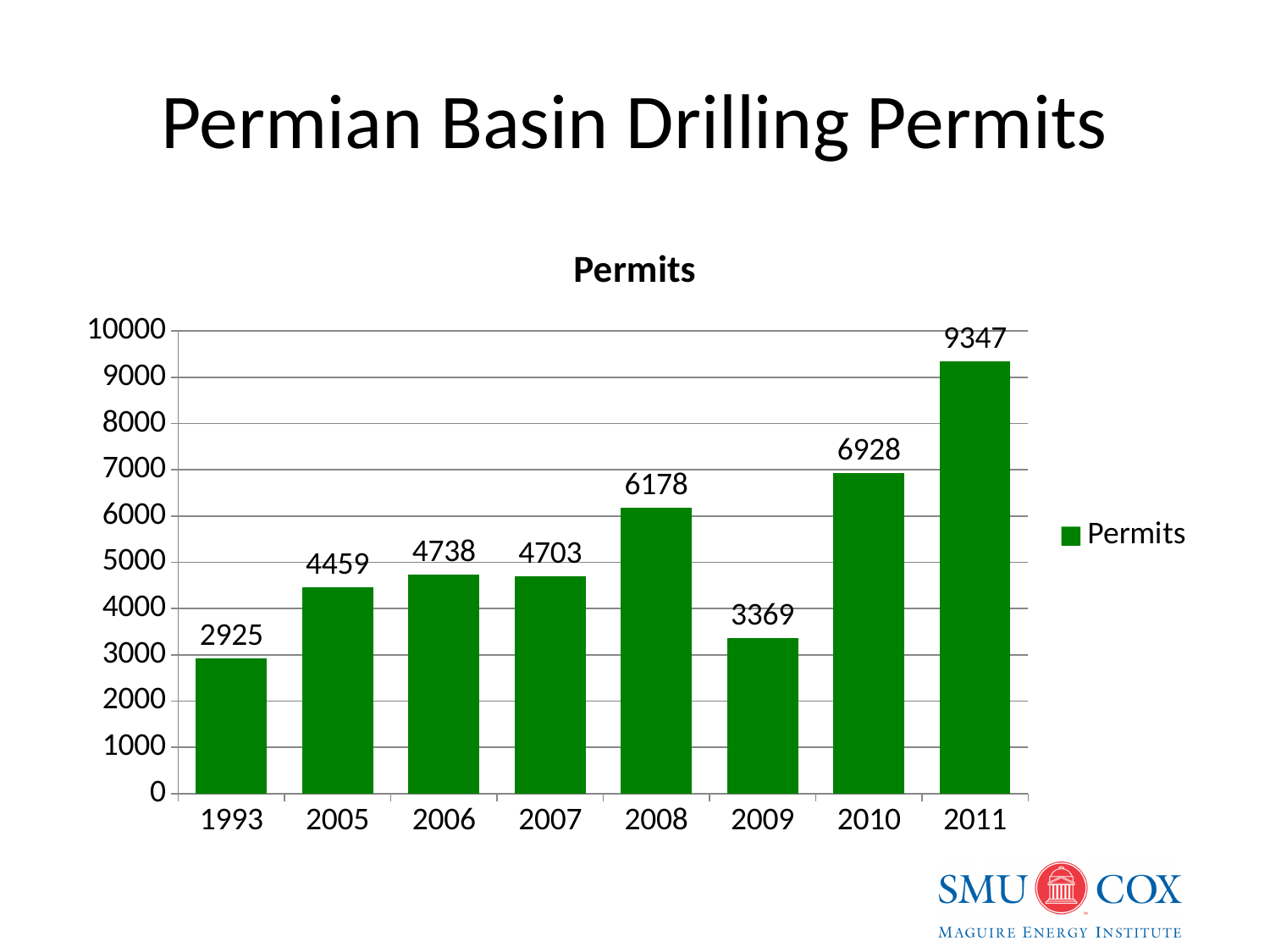
Which year has the lowest number of permits? 1993 What is the value for 2008? 6178 What is the difference between the values for 2011 and 2010? 2419 Is the value for 2009 greater or less than 4000? less How many years are shown on the x axis? 8 Which is larger, the value for 2006 or the value for 2007? 2006 What is the value for 1993? 2925 What is the title of the chart? Permits Do the values rise or fall from 2009 to 2011? rise What kind of chart is shown? bar chart How many series does the legend list? 1 Which year has the highest number of permits? 2011